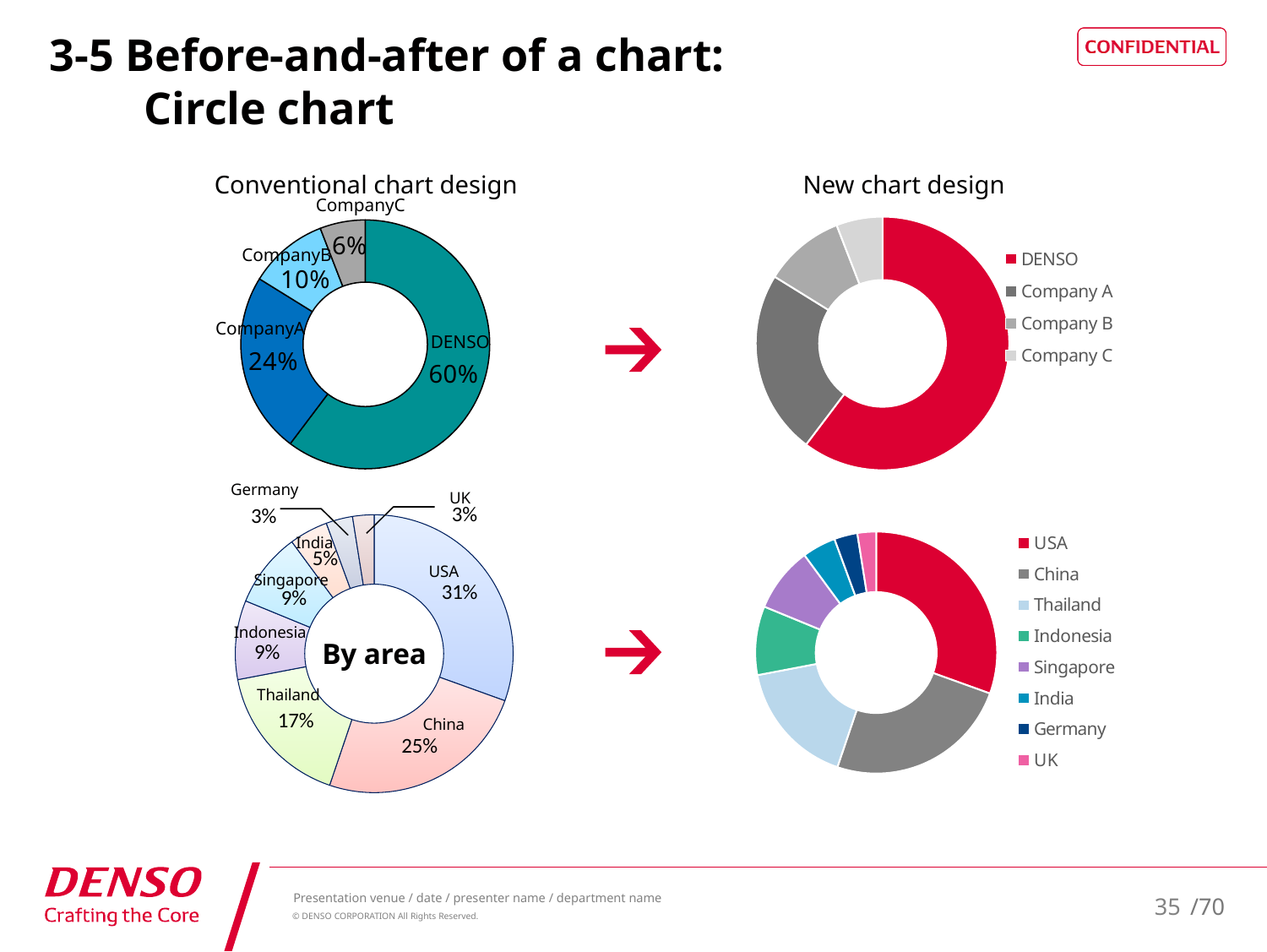
In the bottom-left 'By area' chart, what is the share for China? 25% How many areas are shown in the bottom-left 'By area' chart? 8 In the bottom-left 'By area' chart, what is the difference between USA and Thailand? 14 percentage points In the bottom-left 'By area' chart, which area has the largest share? USA What type of chart is used in the bottom-right new chart design? Donut (pie) chart In the top-left conventional chart, which company has the smallest share? Company C In the bottom-right new chart design, which colour represents USA in the legend? Red In the bottom-left 'By area' chart, which is larger, Thailand or Indonesia? Thailand In the top-left conventional chart, what is the value for Company B? 10% How many entries does the legend of the top-right new chart design list? 4 In the top-left conventional chart, what share does DENSO hold? 60% In the top-left conventional chart, what is the difference between DENSO's share and Company A's share? 36 percentage points